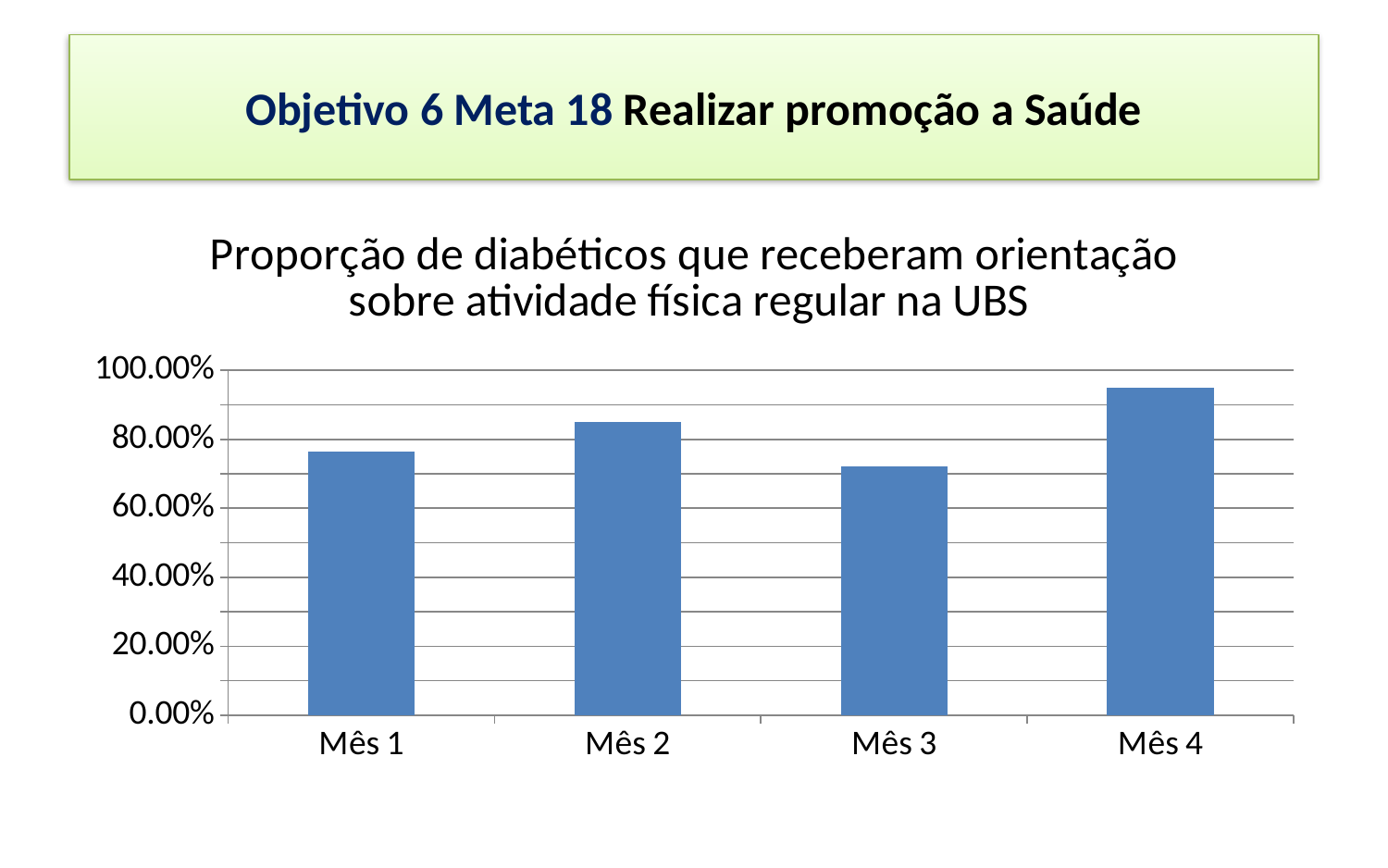
What kind of chart is shown on the slide? bar chart How many categories (months) are plotted on the chart? 4 Which month has the highest proportion of diabetics who received guidance on regular physical activity? Mês 4 Is the value for Mês 2 greater or less than 100.00%? less Which month has the lowest proportion of diabetics who received guidance on regular physical activity? Mês 3 What is the title of the chart? Proporção de diabéticos que receberam orientação sobre atividade física regular na UBS Is the value for Mês 4 greater or less than 80.00%? greater Which is larger, the value for Mês 3 or the value for Mês 4? Mês 4 Which is larger, the value for Mês 2 or the value for Mês 1? Mês 2 What is the highest value shown on the vertical axis? 100.00% Is the value for Mês 3 greater or less than 80.00%? less